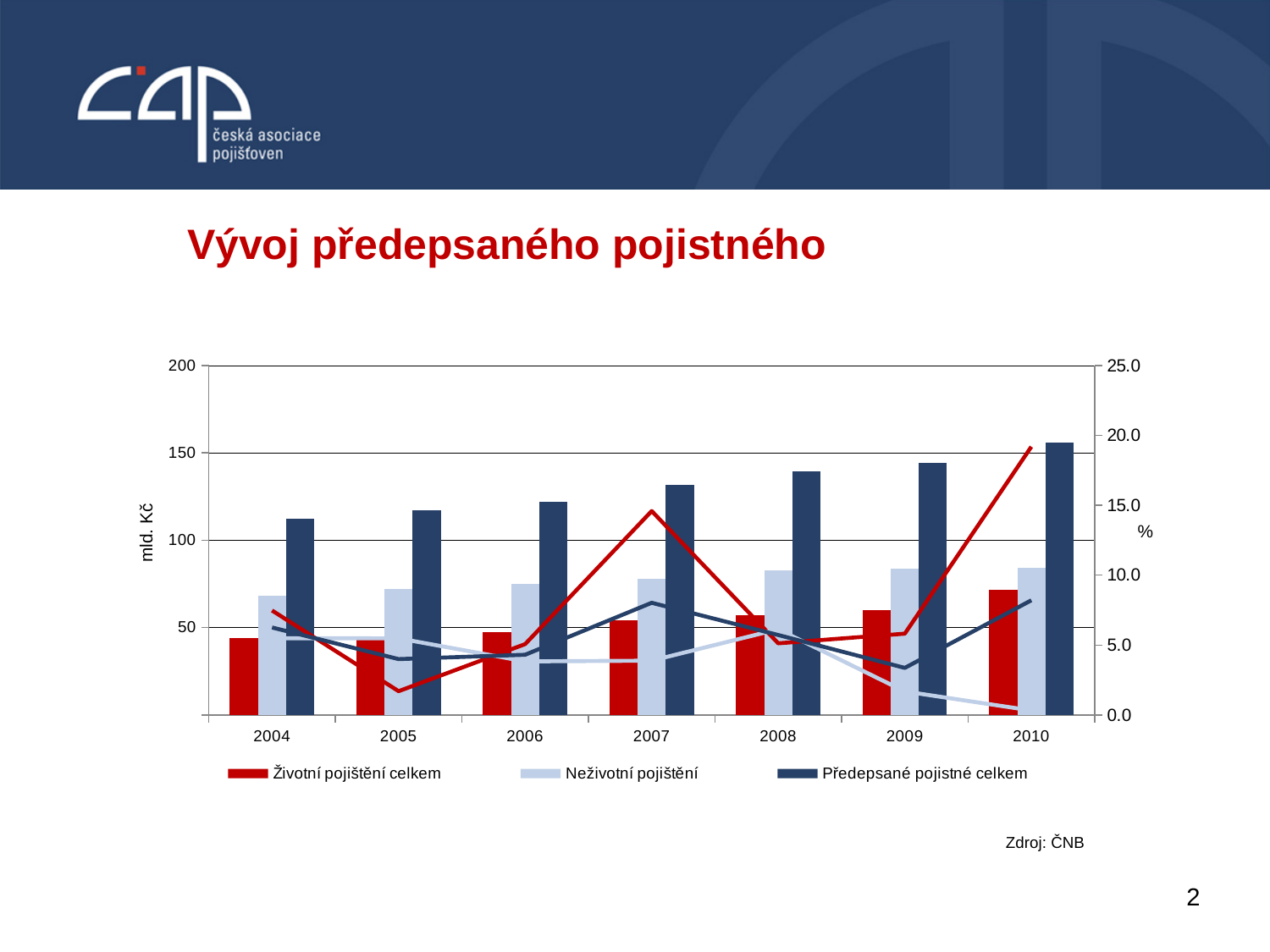
Do the bars for Předepsané pojistné celkem rise or fall from 2004 to 2010? rise In which year is the bar for Předepsané pojistné celkem the highest? 2010 What is the title of the chart on the slide? Vývoj předepsaného pojistného In which year is the bar for Předepsané pojistné celkem the lowest? 2004 How many years are shown on the x axis of the chart? 7 In 2010, which bar is larger: Životní pojištění celkem or Neživotní pojištění? Neživotní pojištění In which year is the bar for Životní pojištění celkem the highest? 2010 Is the bar for Předepsané pojistné celkem in 2010 greater or less than 150? greater Is the bar for Životní pojištění celkem in 2005 greater or less than 50? less How many series does the chart legend list? 3 What unit is shown on the left vertical axis of the chart? mld. Kč What kind of chart is shown on the slide? A combined bar and line chart